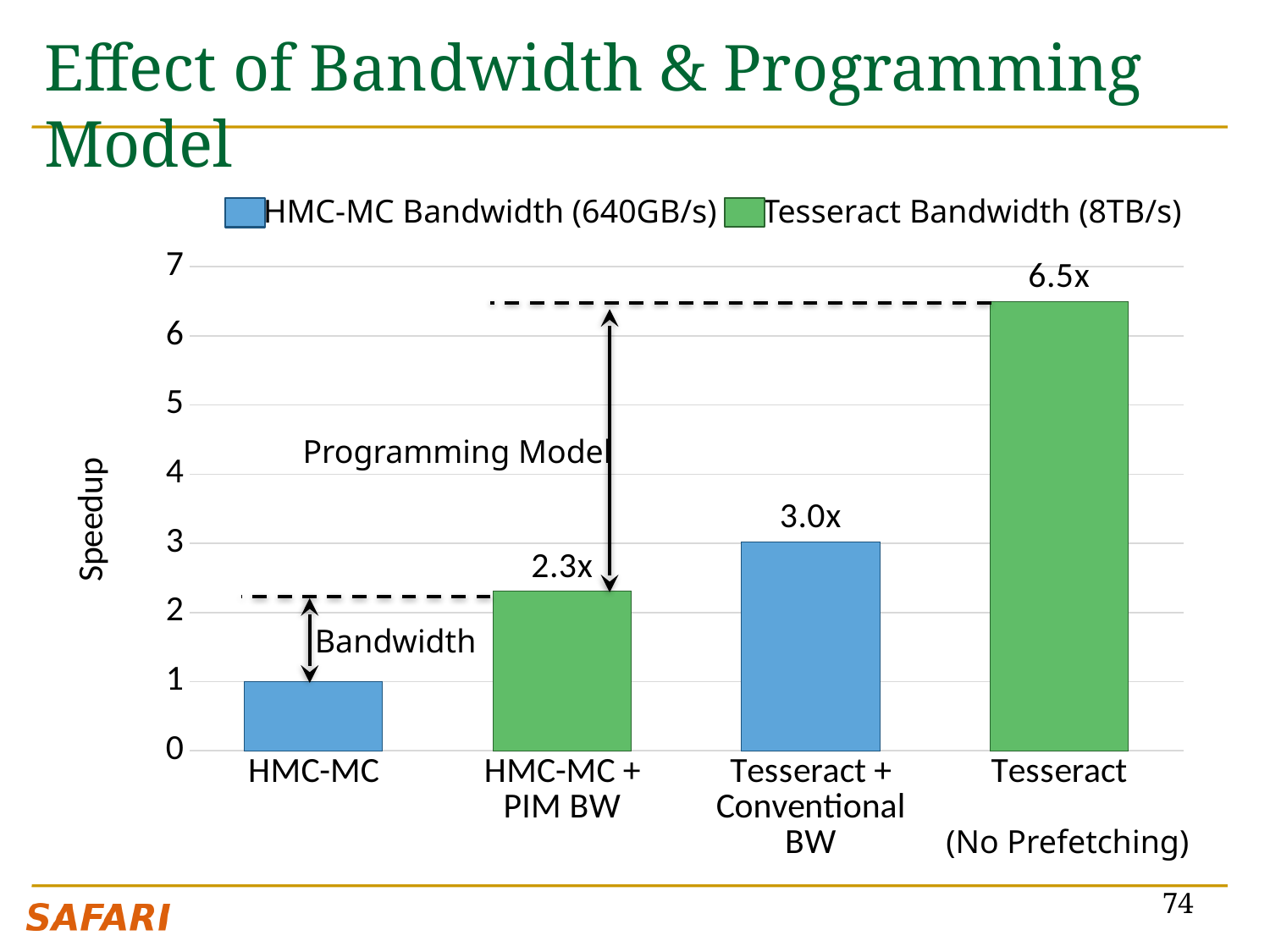
What is the speedup shown for Tesseract + Conventional BW? 3.0x What is the speedup shown for HMC-MC + PIM BW? 2.3x How many series does the legend list? 2 What is the difference in speedup between Tesseract (No Prefetching) and HMC-MC + PIM BW? 4.2x How many configurations (bars) are shown on the chart? 4 Which has a larger speedup, Tesseract + Conventional BW or HMC-MC + PIM BW? Tesseract + Conventional BW Which configuration has the lowest speedup? HMC-MC What is the difference in speedup between Tesseract + Conventional BW and HMC-MC + PIM BW? 0.7x Which configuration has the highest speedup? Tesseract (No Prefetching) Is the speedup for HMC-MC greater or less than 2? less What is the speedup shown for Tesseract (No Prefetching)? 6.5x What kind of chart is shown on the slide? bar chart